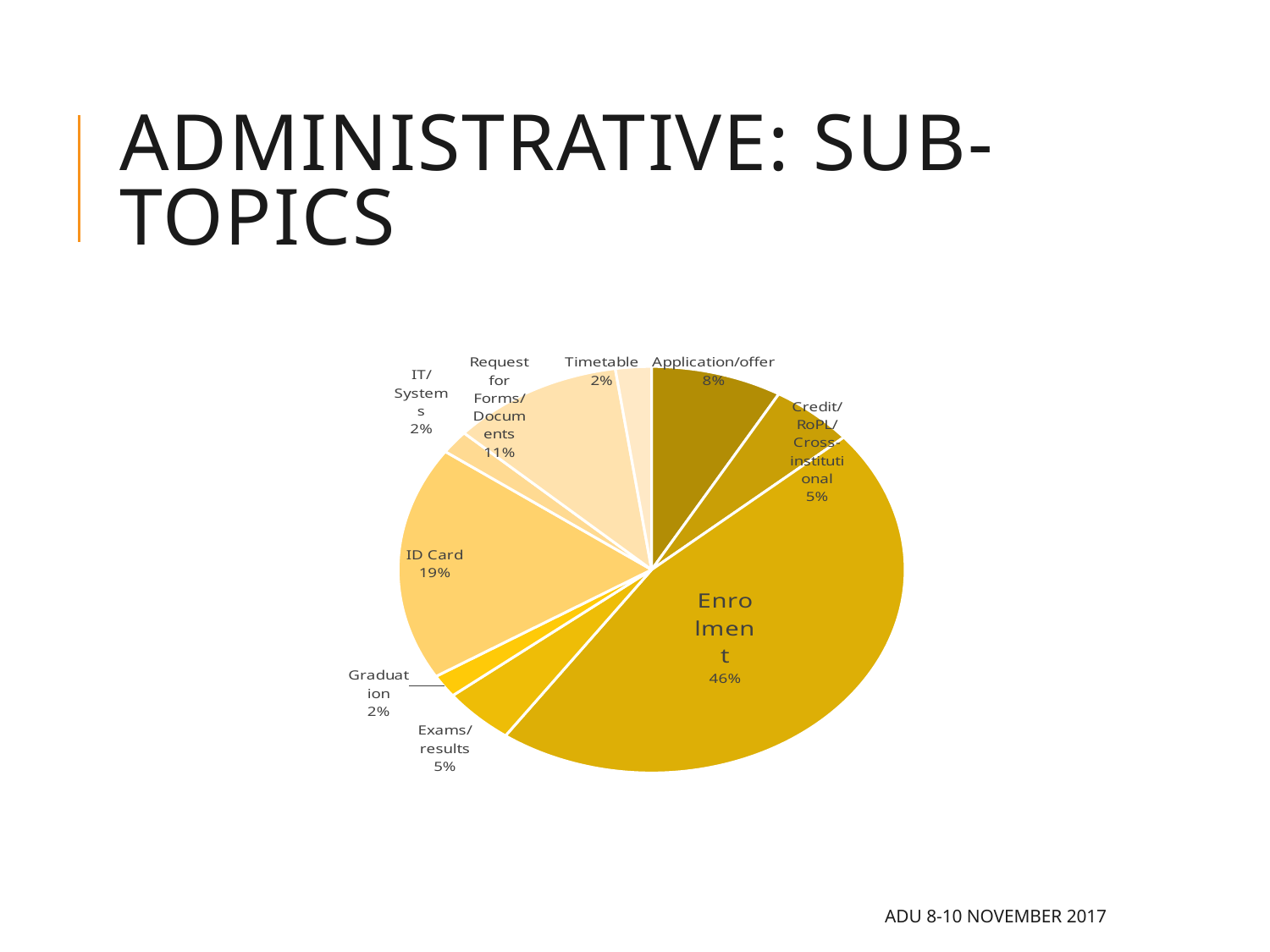
What kind of chart is shown on the slide? Pie chart Which is larger, the share for Application/offer or the share for Exams/results? Application/offer What percentage is shown for Credit/RoPL/Cross-institutional? 5% What percentage is shown for Request for Forms/Documents? 11% How many slices does the pie chart have? 9 What percentage is shown for ID Card? 19% What percentage is shown for Graduation? 2% What share of the pie does Enrolment account for? 46% What is the title of the slide containing the chart? ADMINISTRATIVE: SUB-TOPICS What is the difference in percentage points between Enrolment and ID Card? 27 Which sub-topic has the largest slice of the pie? Enrolment What percentage is shown for Application/offer? 8%